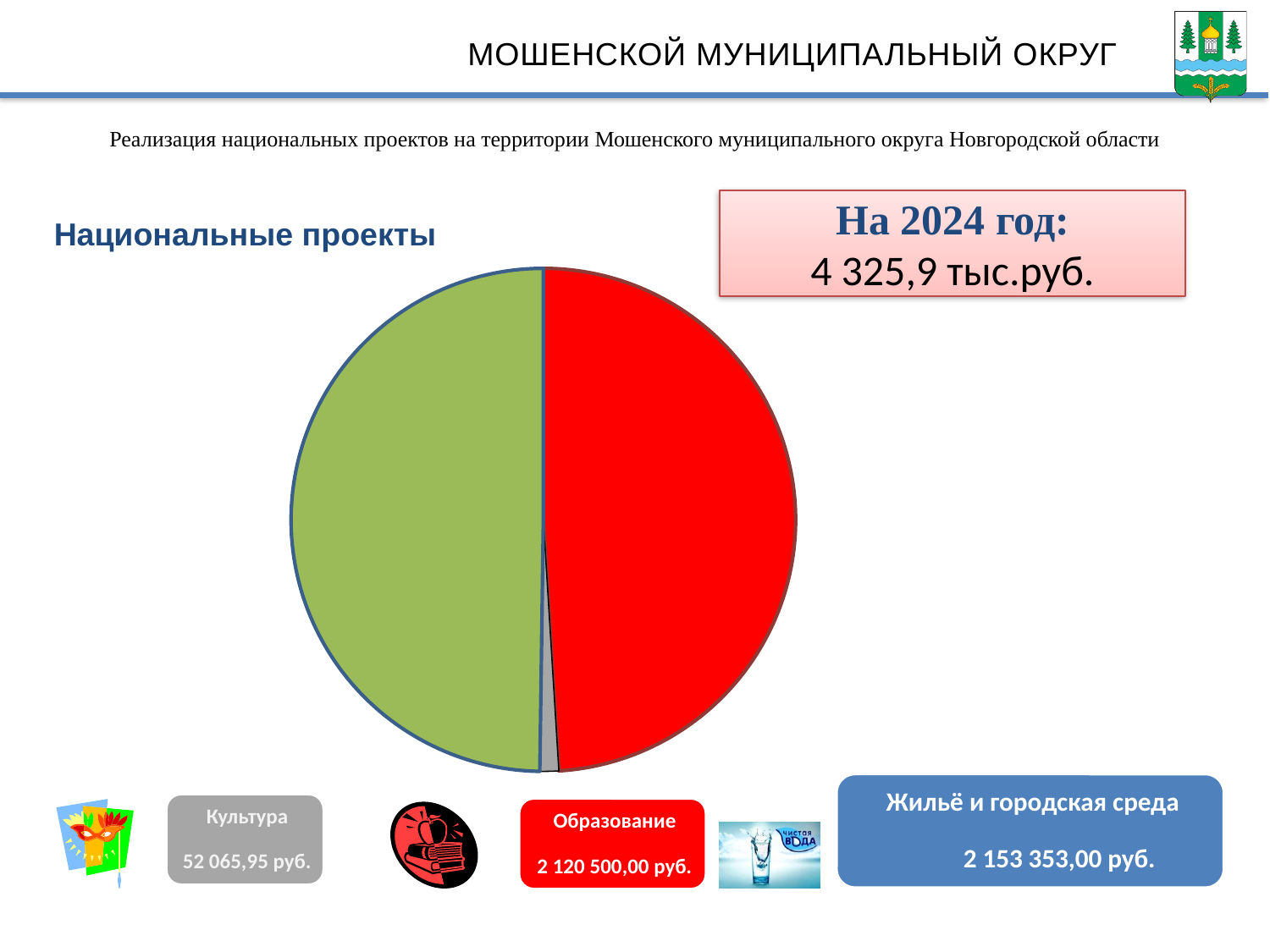
Which category has the largest value? Жильё и городская среда What is the difference between the values for Жильё и городская среда and Образование? 32 853,00 руб. What is the value for Жильё и городская среда? 2 153 353,00 руб. What is the value for Образование? 2 120 500,00 руб. Which is larger, the value for Образование or the value for Жильё и городская среда? Жильё и городская среда What is the title of the pie chart? Национальные проекты How many slices does the pie chart have? 3 What is the total amount for 2024 shown on the slide? 4 325,9 тыс.руб. What is the value for Культура? 52 065,95 руб. What kind of chart is shown on the slide? pie chart Which colour represents Образование in the pie chart? red Which category has the smallest slice of the pie? Культура